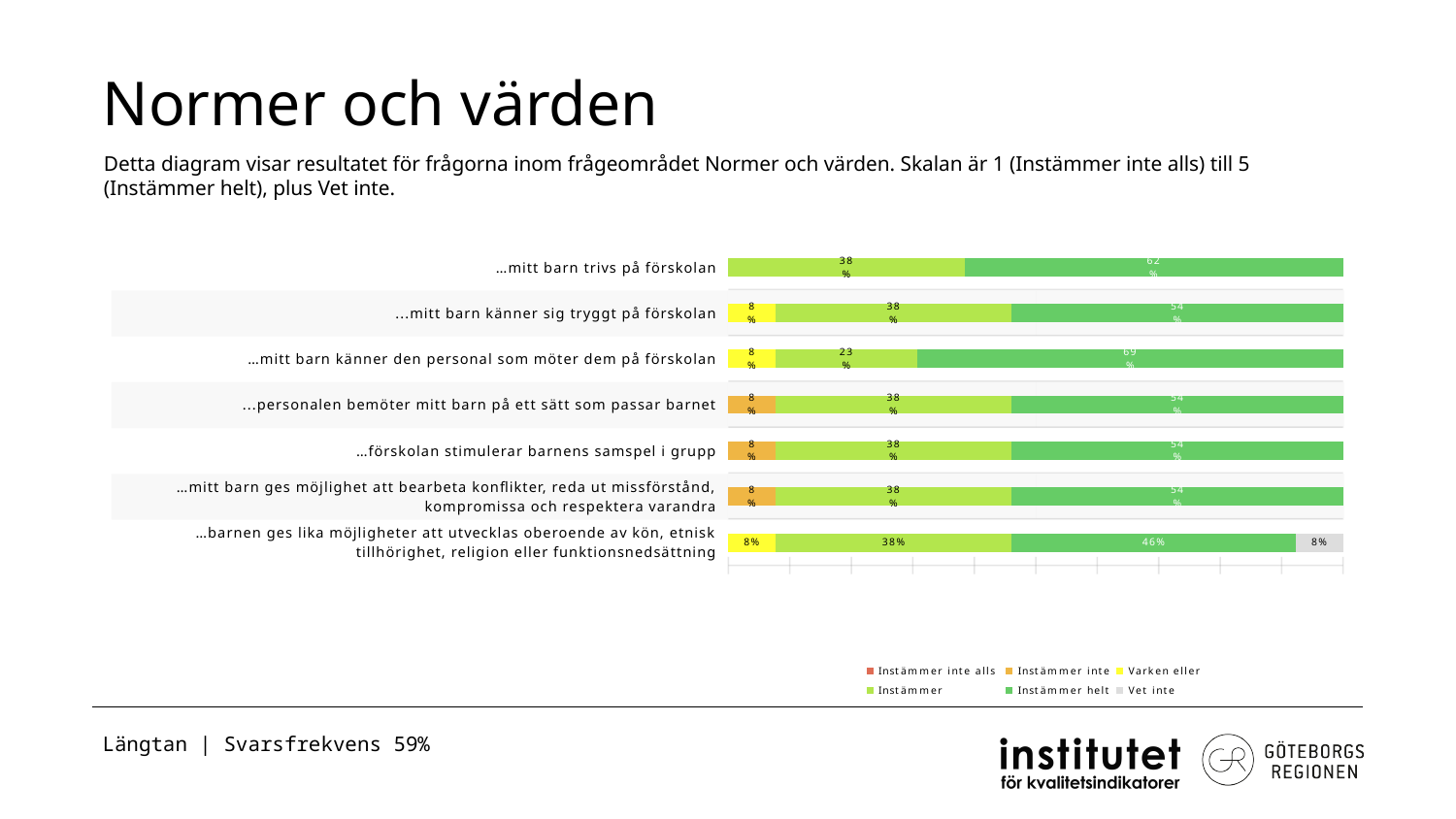
How many series does the legend list? 6 What is the 'Vet inte' value for '…barnen ges lika möjligheter att utvecklas oberoende av kön, etnisk tillhörighet, religion eller funktionsnedsättning'? 8% What kind of chart is shown on the slide? Stacked bar chart Which statement has the highest 'Instämmer helt' share? …mitt barn känner den personal som möter dem på förskolan Which legend entry is shown in grey? Vet inte What is the difference between the 'Instämmer helt' and 'Instämmer' values for '…mitt barn trivs på förskolan'? 24 percentage points How many statements (categories) are plotted in the chart? 7 What is the 'Instämmer helt' value for '…mitt barn trivs på förskolan'? 62% What is the total of the labelled segments for '…mitt barn trivs på förskolan'? 100% Which statement has the lowest 'Instämmer helt' share? …barnen ges lika möjligheter att utvecklas oberoende av kön, etnisk tillhörighet, religion eller funktionsnedsättning Which has a larger 'Instämmer helt' value: '…mitt barn trivs på förskolan' or '…mitt barn känner sig tryggt på förskolan'? …mitt barn trivs på förskolan What is the 'Instämmer' value for '…mitt barn känner den personal som möter dem på förskolan'? 23%